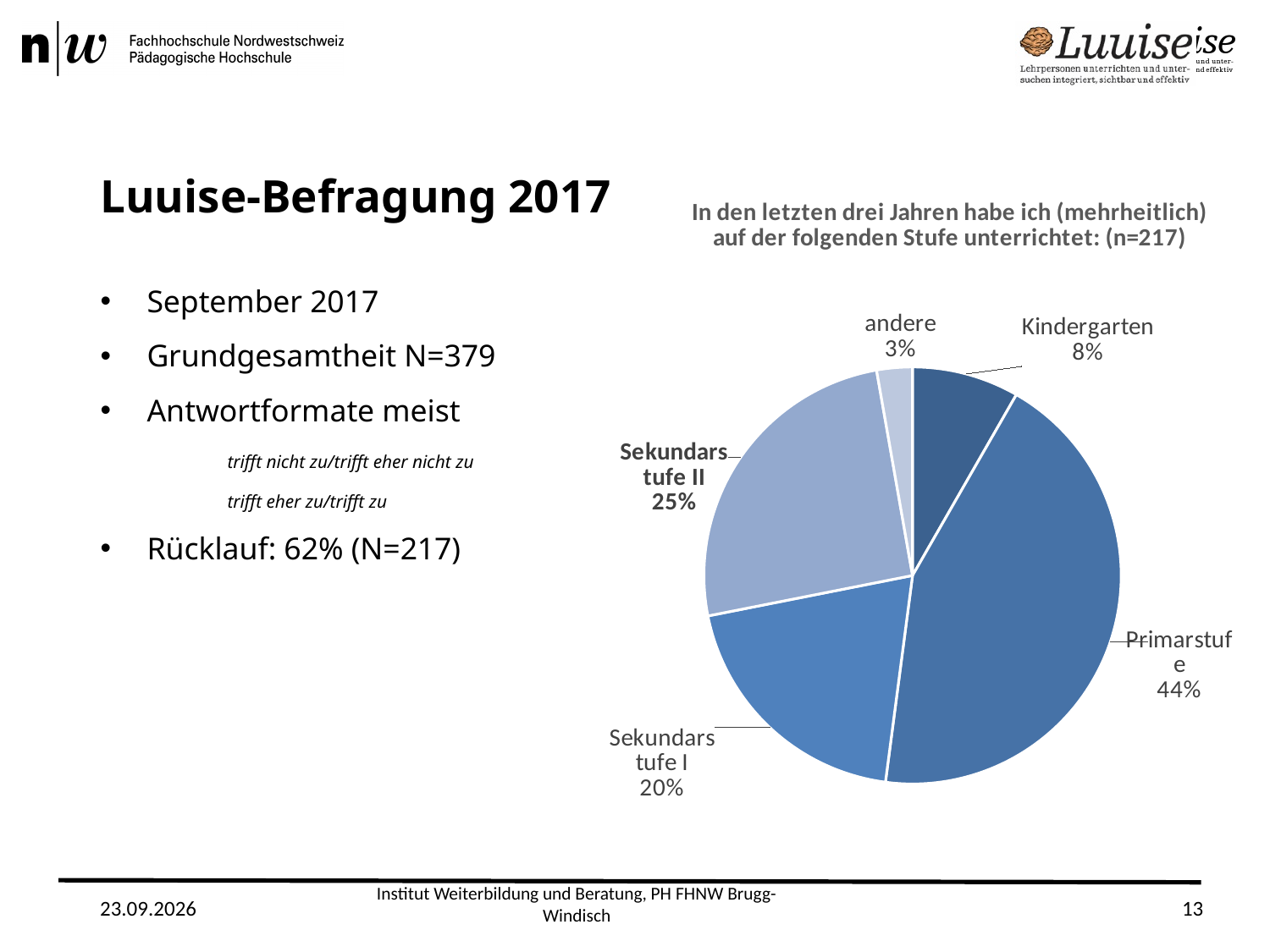
What is the sample size (n) stated in the chart title? 217 What share of the pie does Primarstufe have? 44% Which category has the largest slice of the pie? Primarstufe What share of the pie does Kindergarten have? 8% How many slices does the pie chart have? 5 What is the difference in percentage points between Primarstufe and Sekundarstufe I? 24 What share of the pie does Sekundarstufe II have? 25% Which is larger, the share for Sekundarstufe II or the share for Sekundarstufe I? Sekundarstufe II What share of the pie does Sekundarstufe I have? 20% What kind of chart is shown on the slide? pie chart What share of the pie does the 'andere' slice have? 3% Which category has the smallest slice of the pie? andere